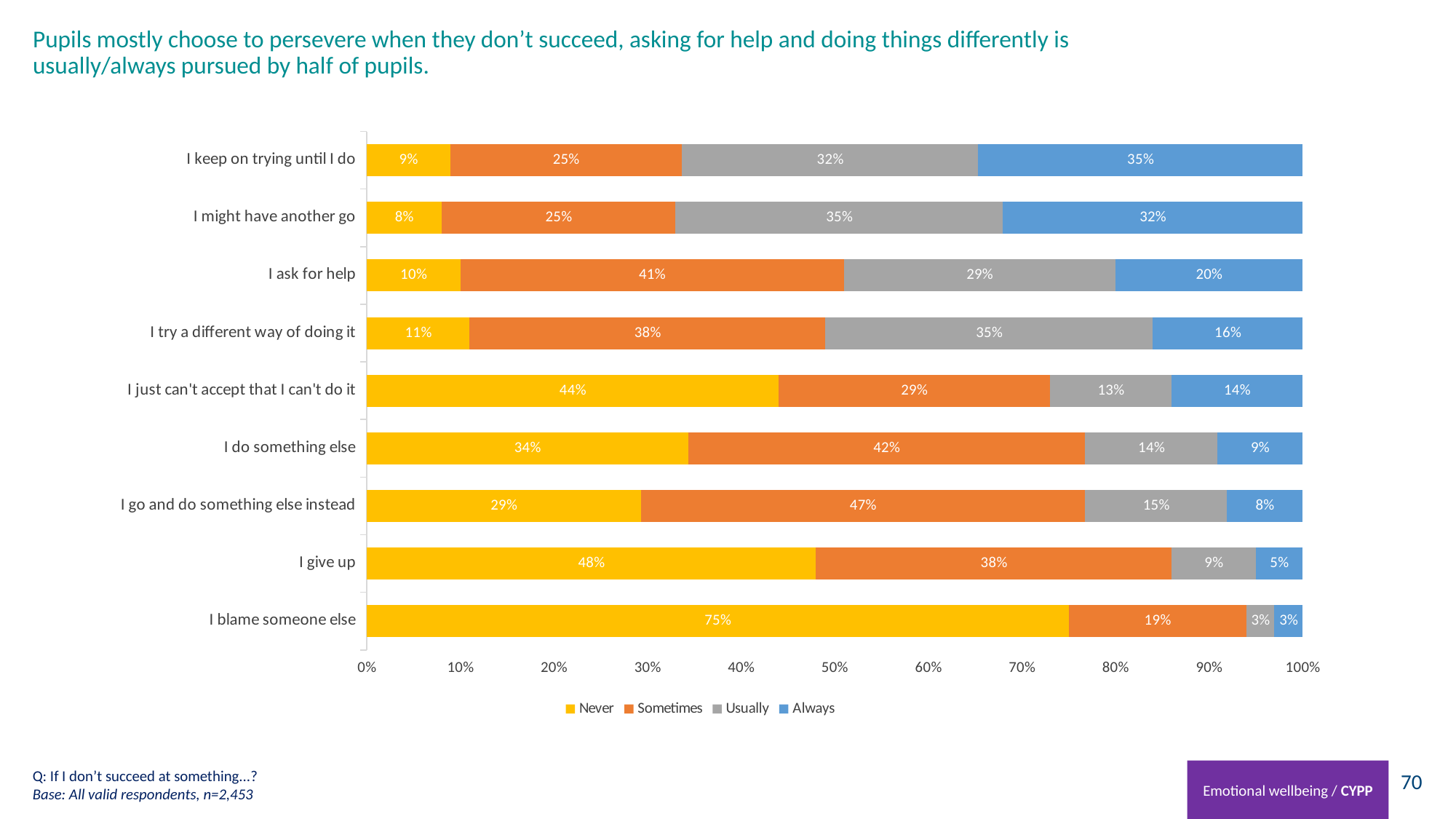
What is the 'Usually' value for 'I try a different way of doing it'? 35% Which category has the highest 'Never' value? I blame someone else How many series does the legend list? 4 What kind of chart is shown on the slide? Stacked bar chart What is the 'Always' value for 'I keep on trying until I do'? 35% How many categories are shown on the chart? 9 Which category has the lowest 'Always' value? I blame someone else What is the combined 'Usually' and 'Always' share for 'I might have another go'? 67% What is the 'Sometimes' value for 'I ask for help'? 41% What percentage of pupils say they 'Never' blame someone else? 75% What is the difference between the 'Never' values for 'I give up' and 'I do something else'? 14% Which is larger: the 'Sometimes' value for 'I go and do something else instead' or for 'I do something else'? I go and do something else instead